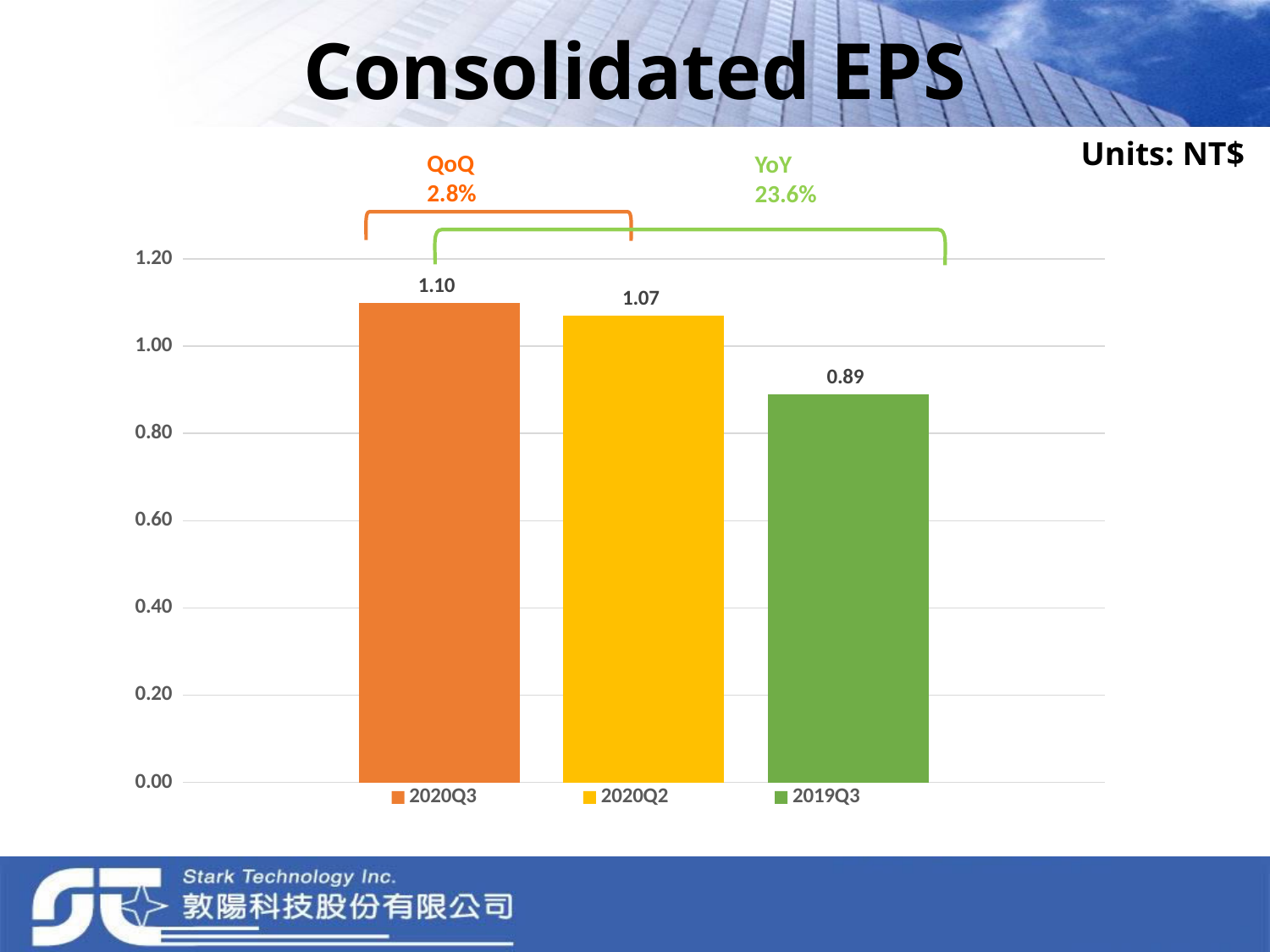
Is the Consolidated EPS for 2019Q3 greater or less than 1.00? less What is the difference in Consolidated EPS between 2020Q3 and 2019Q3? 0.21 What is the Consolidated EPS value for 2019Q3? 0.89 What YoY percentage change is shown on the Consolidated EPS chart? 23.6% Which is larger, the Consolidated EPS for 2020Q2 or for 2019Q3? 2020Q2 What kind of chart is used to show Consolidated EPS? bar chart Which period has the highest Consolidated EPS? 2020Q3 What is the Consolidated EPS value for 2020Q2? 1.07 What is the Consolidated EPS value for 2020Q3? 1.10 What is the difference in Consolidated EPS between 2020Q3 and 2020Q2? 0.03 How many periods are shown in the Consolidated EPS chart? 3 Which period has the lowest Consolidated EPS? 2019Q3